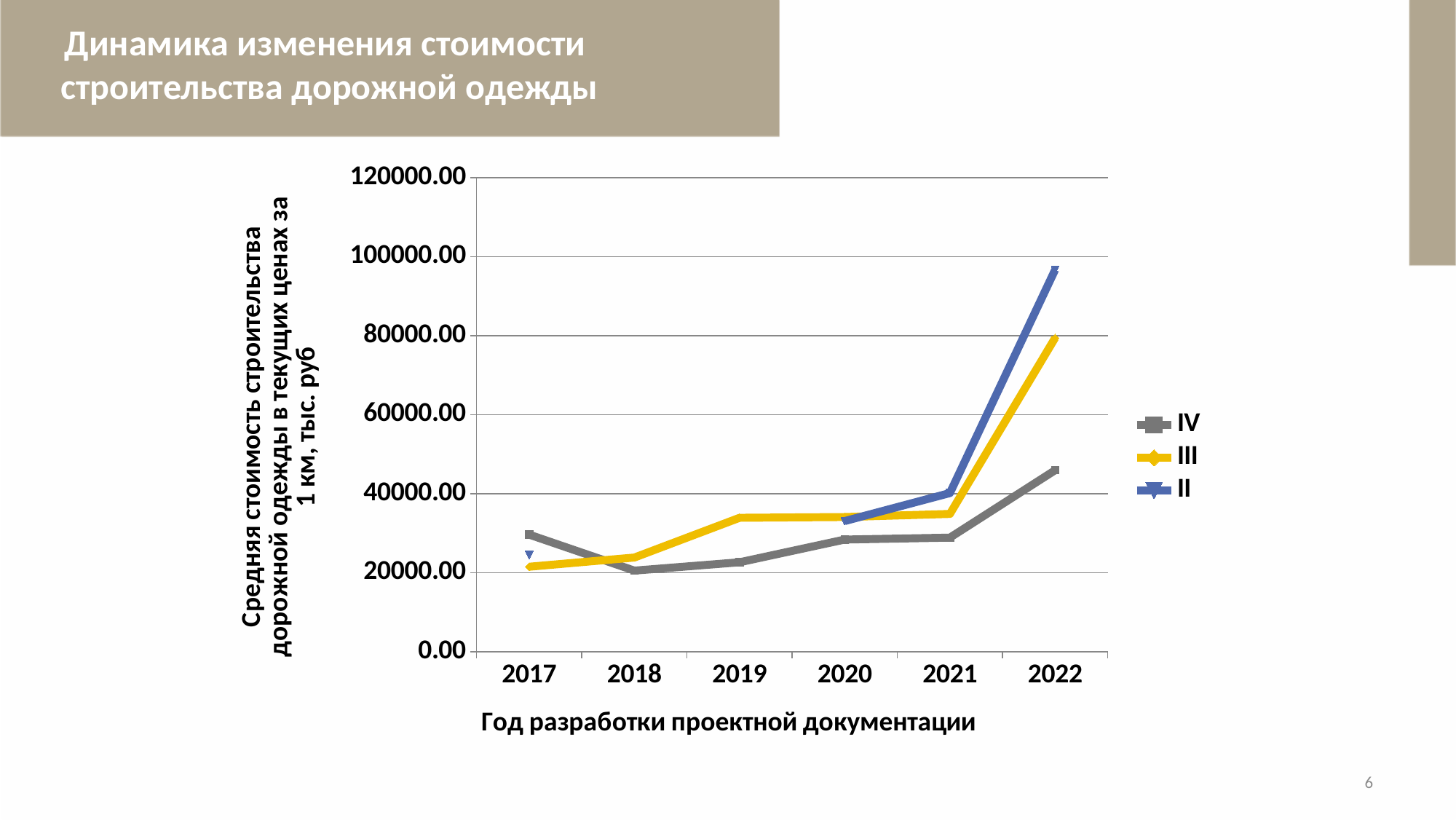
How many series does the legend list? 3 How many years are shown on the x axis? 6 What is the title of the x axis? Год разработки проектной документации Which series has the lowest value in 2022? IV Is the value for series III in 2019 greater or less than 30000.00? greater Is the value for series III in 2022 greater or less than 60000.00? greater What kind of chart is shown on the slide? line chart In 2017, which series has the larger value, IV or III? IV Does the value for series III rise or fall from 2019 to 2022? rise Which series has the highest value in 2022? II Is the value for series IV in 2022 greater or less than 40000.00? greater